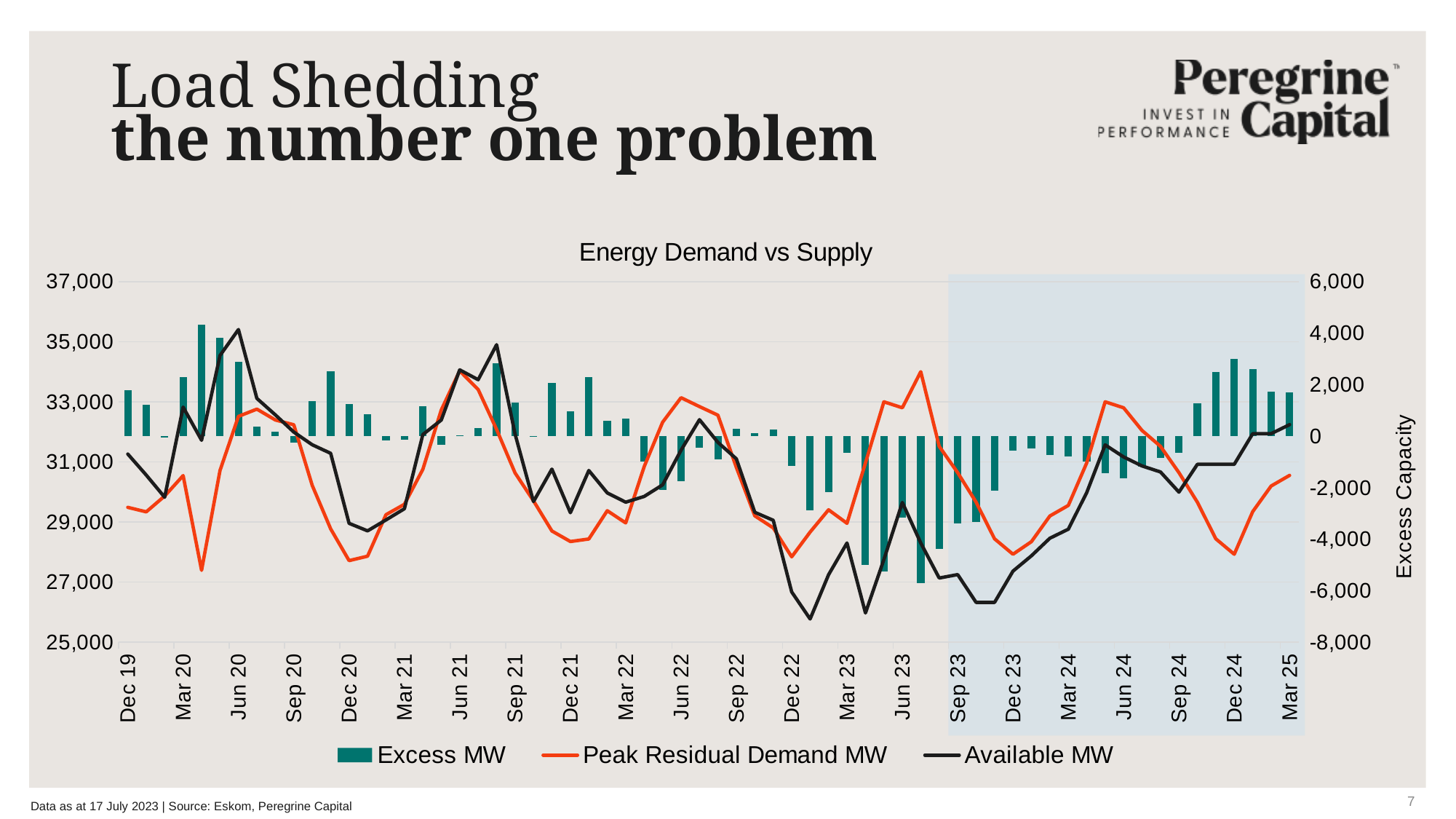
Which series is plotted as bars? Excess MW What is the title of the chart? Energy Demand vs Supply Is the Available MW value at Jun 20 greater or less than 35,000? greater Is the Excess MW value at Jun 23 greater or less than -4,000? greater Does the Peak Residual Demand MW line rise or fall from Dec 23 to Jun 24? rise How many series does the chart's legend list? 3 At Jun 20, which is higher: Available MW or Peak Residual Demand MW? Available MW What kind of chart is shown on the slide? Combination bar and line chart Is the Peak Residual Demand MW value at Dec 19 greater or less than 29,000? greater Does the Available MW line rise or fall from Sep 22 to Dec 22? fall At Dec 22, which is higher: Available MW or Peak Residual Demand MW? Peak Residual Demand MW